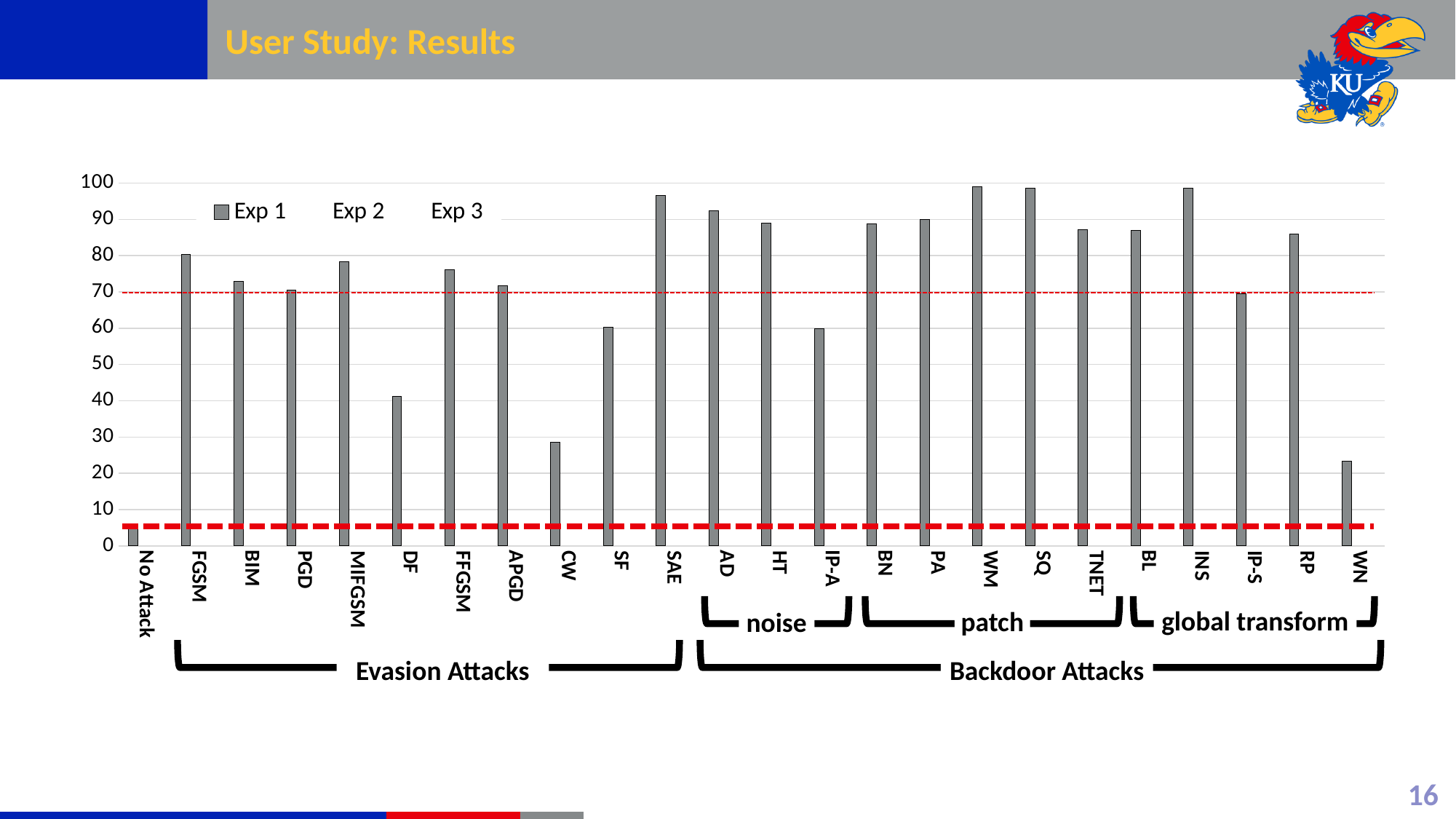
How many categories are plotted along the x axis of the chart? 24 Is the value for FGSM greater or less than 70? greater Is the value for DF greater or less than 50? less Which has the larger value, SAE or SF? SAE What are the names of the series listed in the chart legend? Exp 1, Exp 2, Exp 3 Is the value for CW greater or less than 30? less Which category has the lowest value in the chart? No Attack How many series does the chart legend list? 3 What kind of chart is shown on the slide? bar chart Which has the larger value, DF or CW? DF